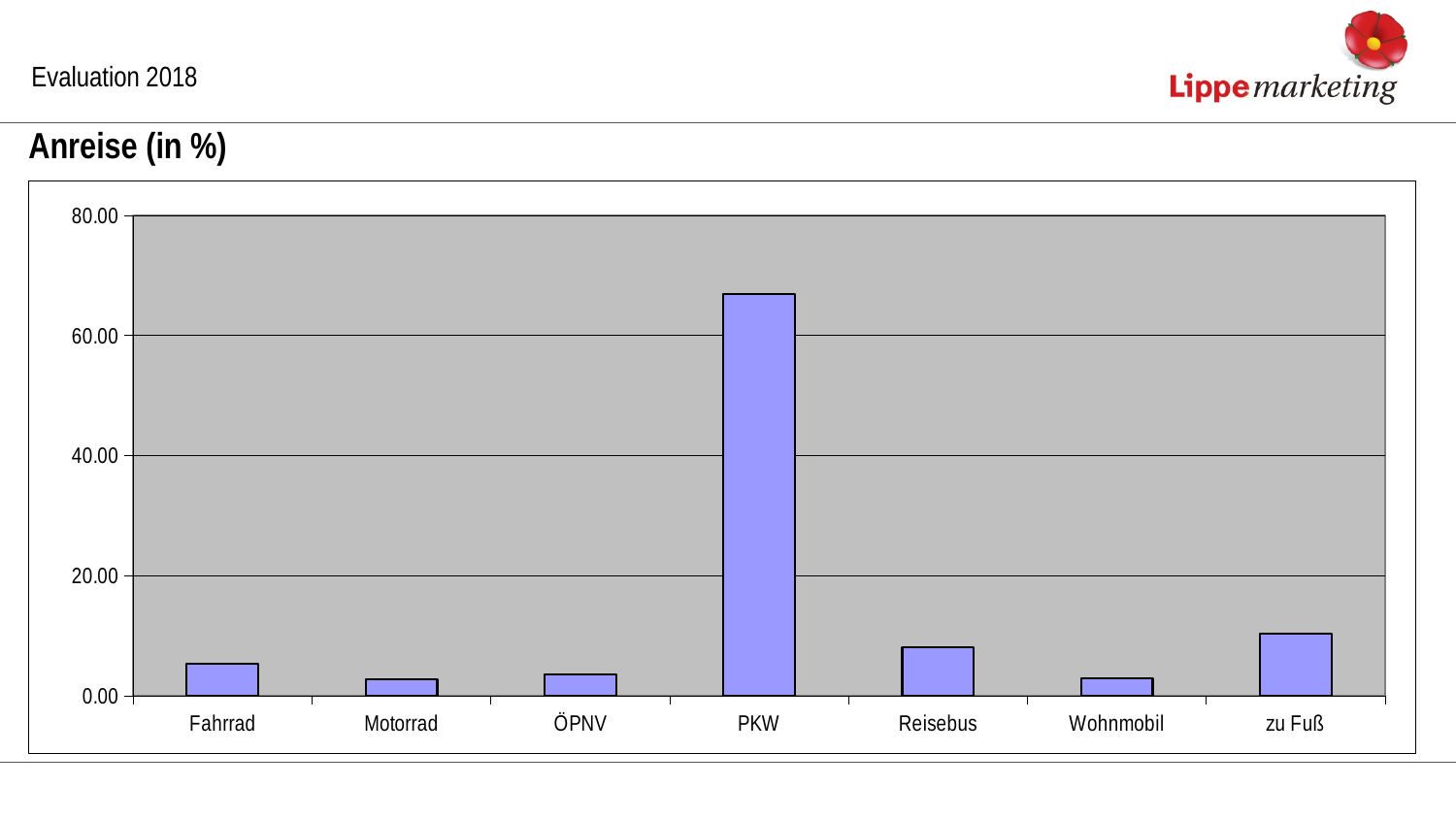
Is the value for zu Fuß greater or less than 20.00? less Which category has the highest value in the chart? PKW Is the value for Reisebus greater or less than 20.00? less How many categories are shown on the x axis of the chart? 7 Is the value for PKW greater or less than 80.00? less Which has a larger value, zu Fuß or Fahrrad? zu Fuß Which has a larger value, Reisebus or ÖPNV? Reisebus What is the title of the chart on the slide? Anreise (in %) What kind of chart is shown on the slide? bar chart Which has a larger value, PKW or Reisebus? PKW What is the highest value shown on the y axis of the chart? 80.00